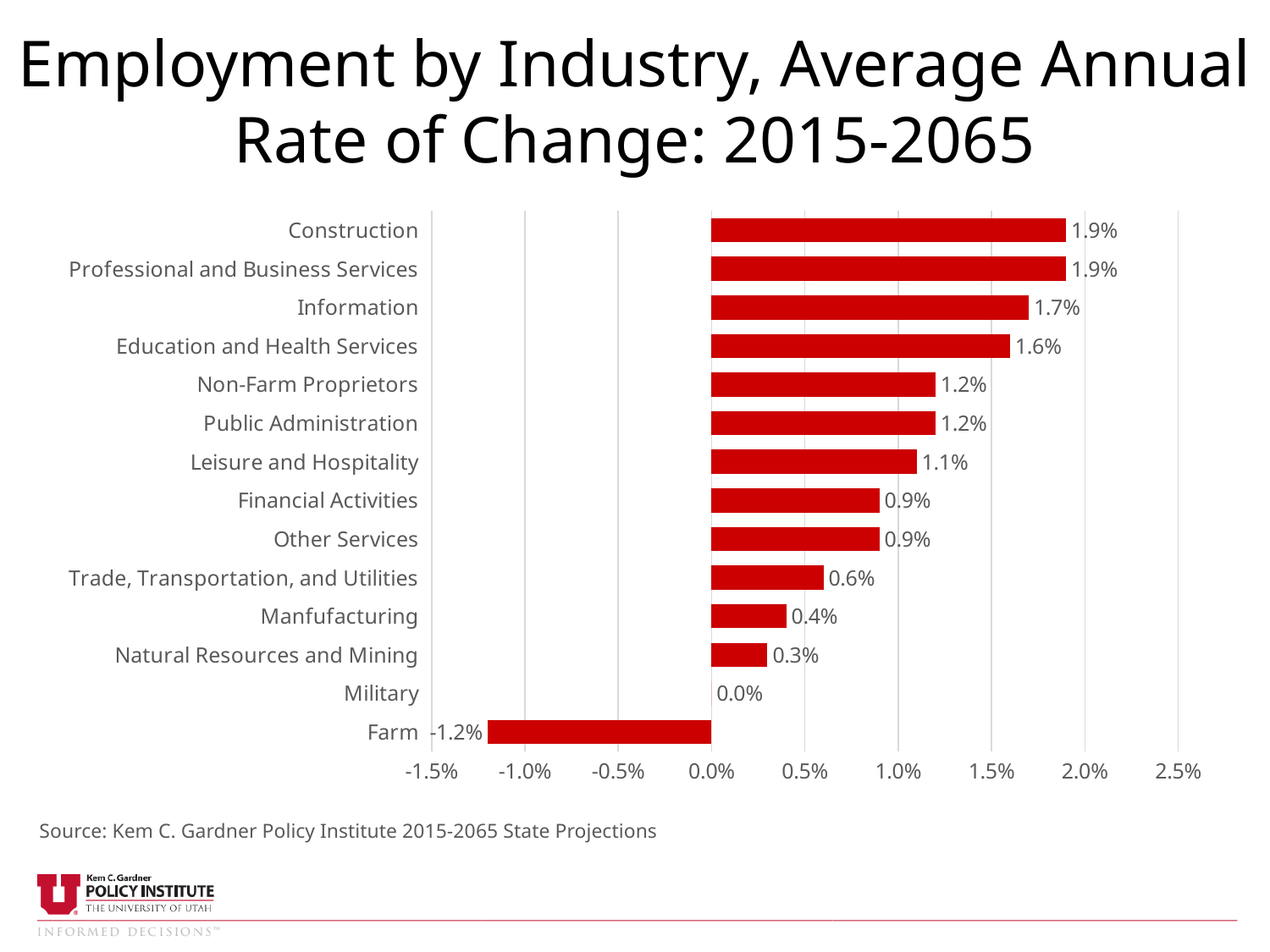
What is the value shown for Trade, Transportation, and Utilities? 0.6% What is the title of the chart? Employment by Industry, Average Annual Rate of Change: 2015-2065 How many industries are shown in the chart? 14 Which is larger, the value for Leisure and Hospitality or the value for Financial Activities? Leisure and Hospitality What is the difference between the values for Education and Health Services and Natural Resources and Mining? 1.3% What is the average annual rate of change for Farm? -1.2% Which industry has the lowest average annual rate of change? Farm What is the average annual rate of change for Information? 1.7% What is the value shown for Military? 0.0% Is the value for Non-Farm Proprietors greater or less than 1.0%? greater What kind of chart is shown on the slide? bar chart How many industries have a value of 1.9%? 2